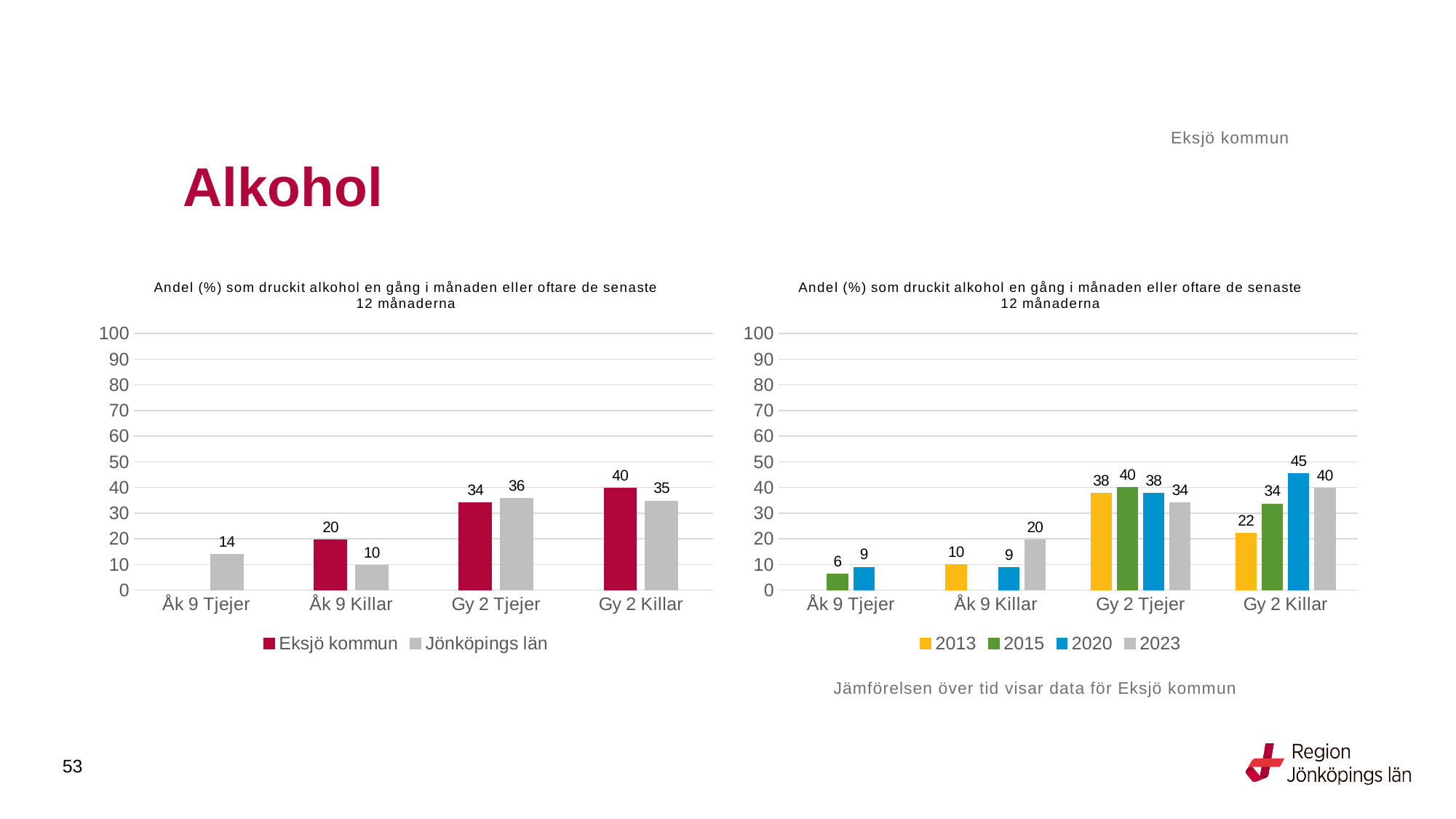
In the left chart, which category has the highest value for Eksjö kommun? Gy 2 Killar How many series does the legend of the left chart list? 2 In the left chart, which is larger for Gy 2 Tjejer: Eksjö kommun or Jönköpings län? Jönköpings län In the right chart, which year has the lowest value for Gy 2 Killar? 2013 In the right chart, what is the value for 2020 for Gy 2 Killar? 45 In the left chart, what is the difference between Eksjö kommun and Jönköpings län for Åk 9 Killar? 10 How many series does the legend of the right chart list? 4 What type of chart is the right chart? Bar chart In the right chart, what is the difference between the 2020 and 2023 values for Gy 2 Killar? 5 In the left chart, what is the value for Eksjö kommun for Åk 9 Killar? 20 In the left chart, what is the value for Jönköpings län for Gy 2 Tjejer? 36 In the right chart, what is the value for 2023 for Åk 9 Killar? 20